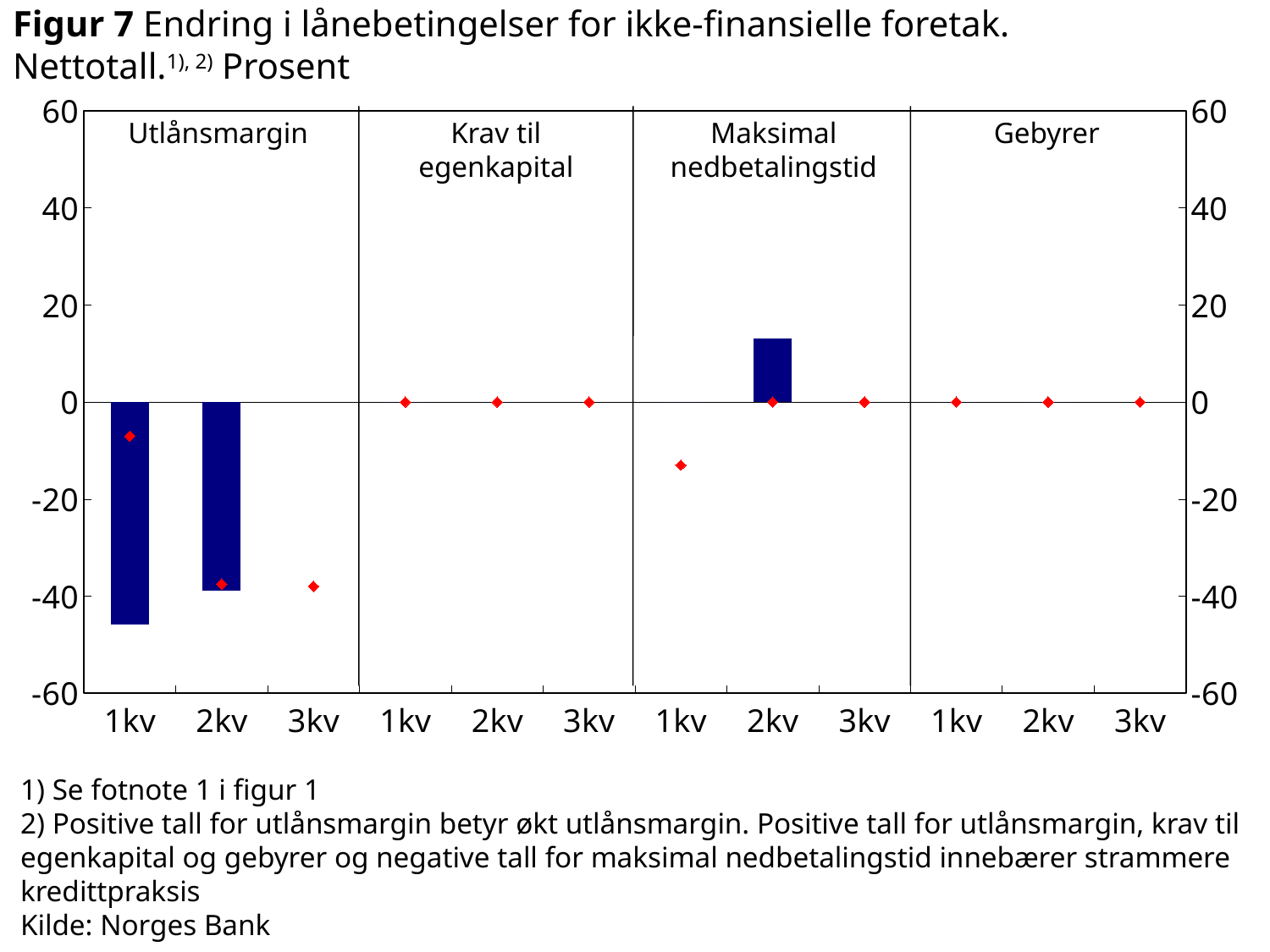
Which panel contains the only positive bar in the chart? Maksimal nedbetalingstid How many panels (loan condition categories) does the chart have? 4 In the Utlånsmargin panel, is the bar for 1kv greater or less than -40? less How many quarters are shown on the x axis within each panel? 3 What kind of chart is shown in Figur 7? bar chart What value do the red markers show for all three quarters in the Krav til egenkapital panel? 0 In the Maksimal nedbetalingstid panel, is the bar for 2kv greater or less than 20? less What is the maximum value shown on the vertical axis? 60 In the Maksimal nedbetalingstid panel, is the red marker for 1kv greater or less than 0? less In the Utlånsmargin panel, is the bar for 1kv or the bar for 2kv lower? 1kv In the Utlånsmargin panel, which quarter has the lowest bar? 1kv